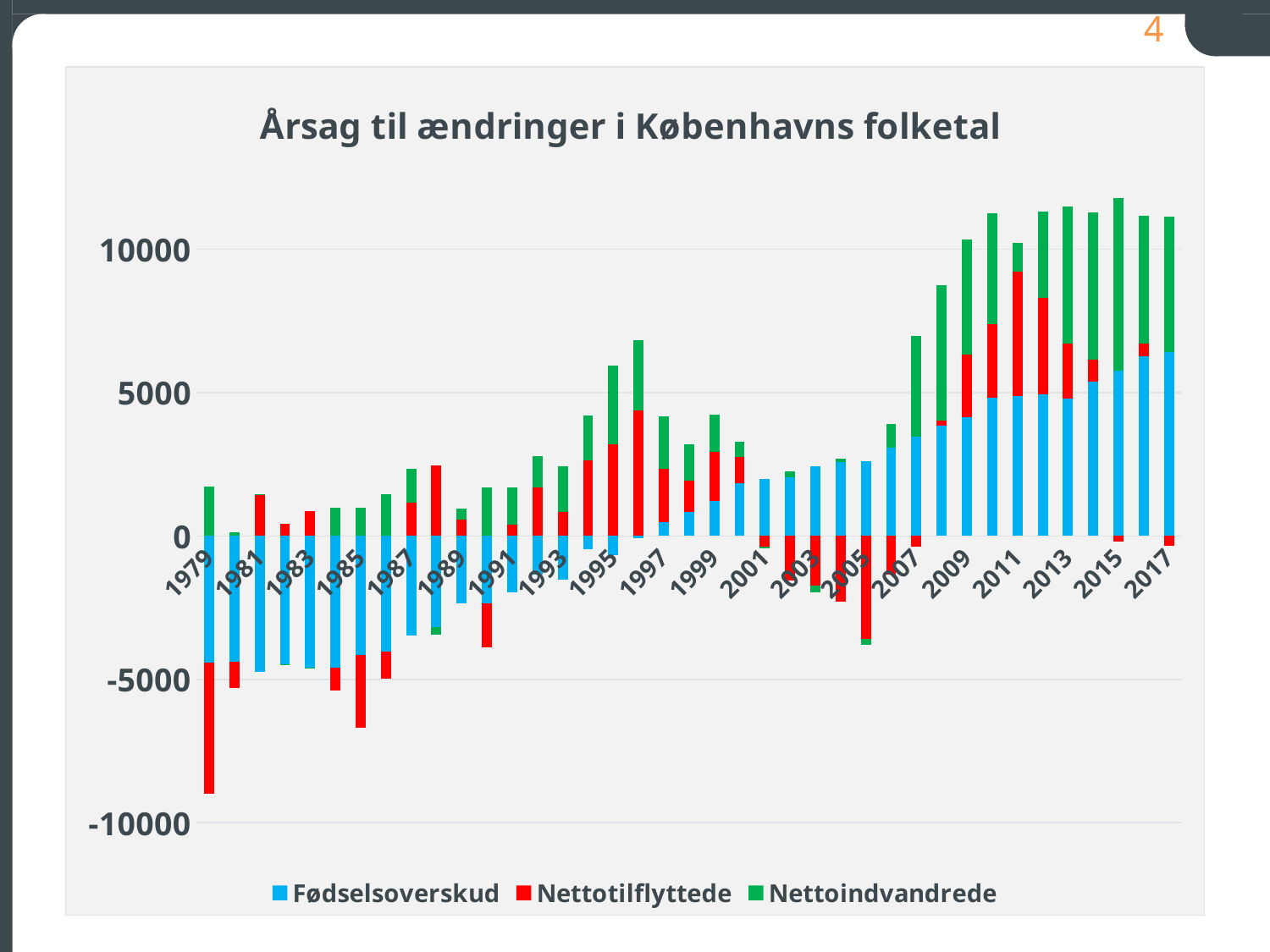
Is the value for Fødselsoverskud in 2017 greater or less than 5000? greater How many series does the legend list? 3 What is the title of the chart? Årsag til ændringer i Københavns folketal What kind of chart is shown on the slide? Stacked bar chart Which colour represents Nettoindvandrede in the chart? Green Which year has the lowest (most negative) value for Nettotilflyttede? 1979 Is the top of the stacked bar for 2007 greater or less than 10000? less Which is larger, Fødselsoverskud in 2007 or in 2017? 2017 Is the value for Fødselsoverskud in 1979 greater or less than -5000? greater How many year labels are shown on the x axis? 20 Does Fødselsoverskud generally rise or fall from 2007 to 2017? rise